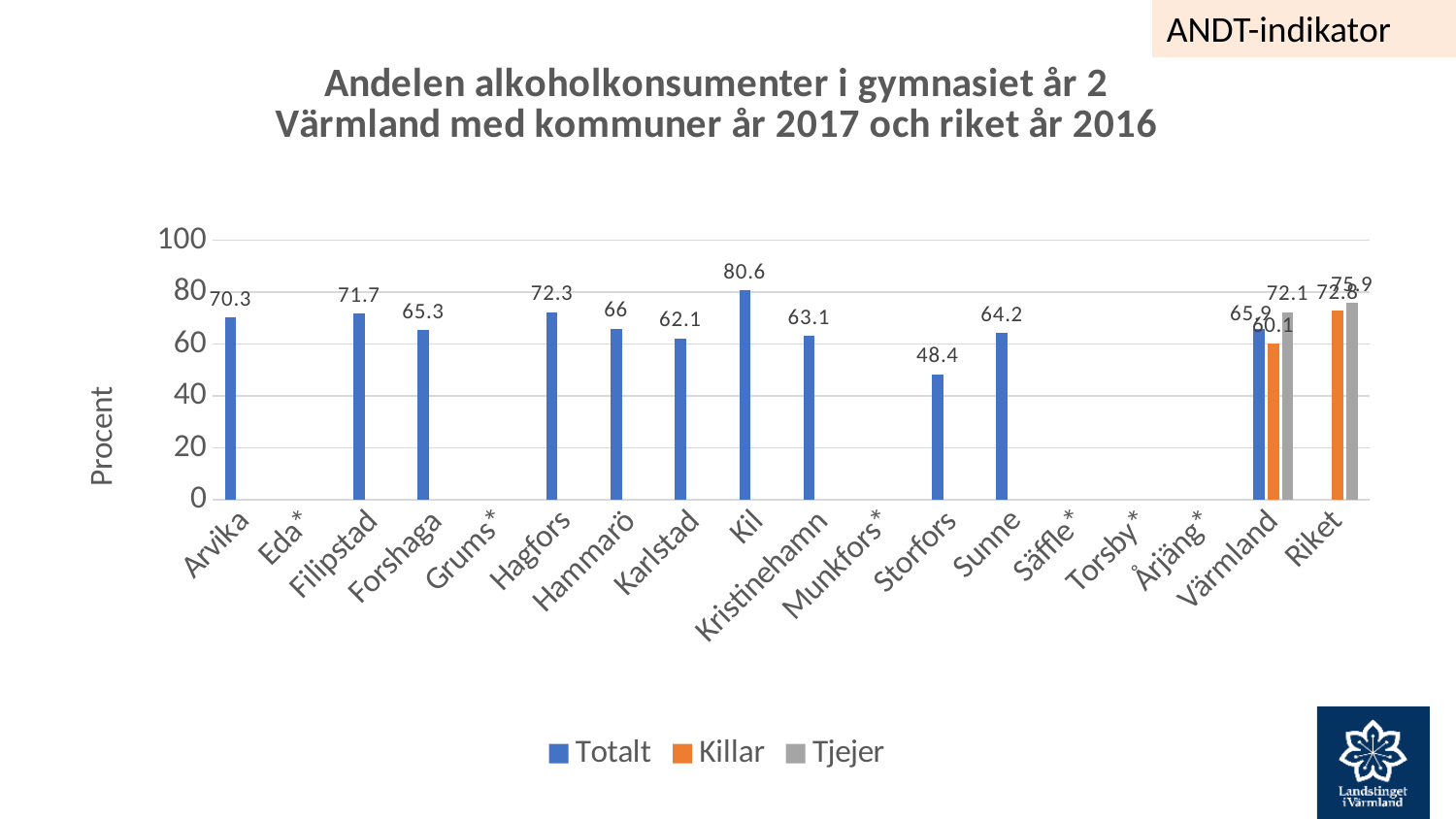
What is the Totalt value for Kil? 80.6 What kind of chart is shown on the slide? Bar chart Which has a higher Totalt value, Filipstad or Hagfors? Hagfors What is the difference between the Totalt values for Kil and Storfors? 32.2 What is the Killar value for Värmland? 60.1 What is the label on the vertical axis? Procent What is the Totalt value for Storfors? 48.4 Which municipality has the highest Totalt value? Kil Which category has the lowest plotted Totalt value? Storfors How many series does the legend list? 3 What is the Tjejer value for Riket? 75.9 What is the difference between the Tjejer and Killar values for Värmland? 12